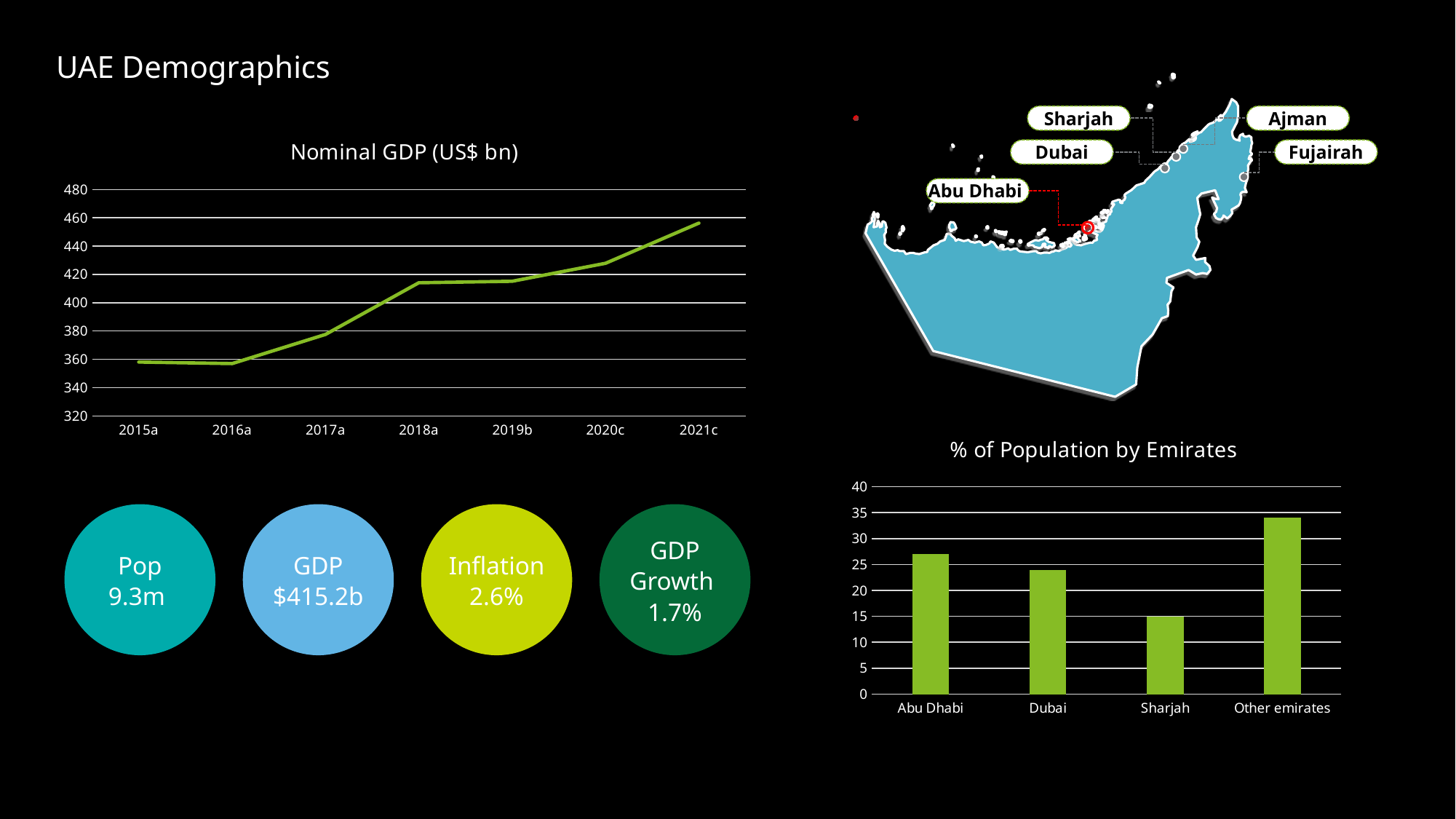
On the "% of Population by Emirates" chart, which is larger, Abu Dhabi or Dubai? Abu Dhabi On the "Nominal GDP (US$ bn)" chart, which year has the highest value? 2021c What kind of chart is the "% of Population by Emirates" chart? bar chart On the "% of Population by Emirates" chart, which category has the lowest value? Sharjah How many data points are plotted on the "Nominal GDP (US$ bn)" chart? 7 On the "% of Population by Emirates" chart, which category has the highest value? Other emirates On the "% of Population by Emirates" chart, is the value for Other emirates greater or less than 30? greater What kind of chart is the "Nominal GDP (US$ bn)" chart? line chart On the "Nominal GDP (US$ bn)" chart, is the value for 2015a greater or less than 380? less On the "Nominal GDP (US$ bn)" chart, is the value for 2021c greater or less than 440? greater On the "Nominal GDP (US$ bn)" chart, do the values generally rise or fall from 2015a to 2021c? rise How many categories are shown on the "% of Population by Emirates" chart? 4